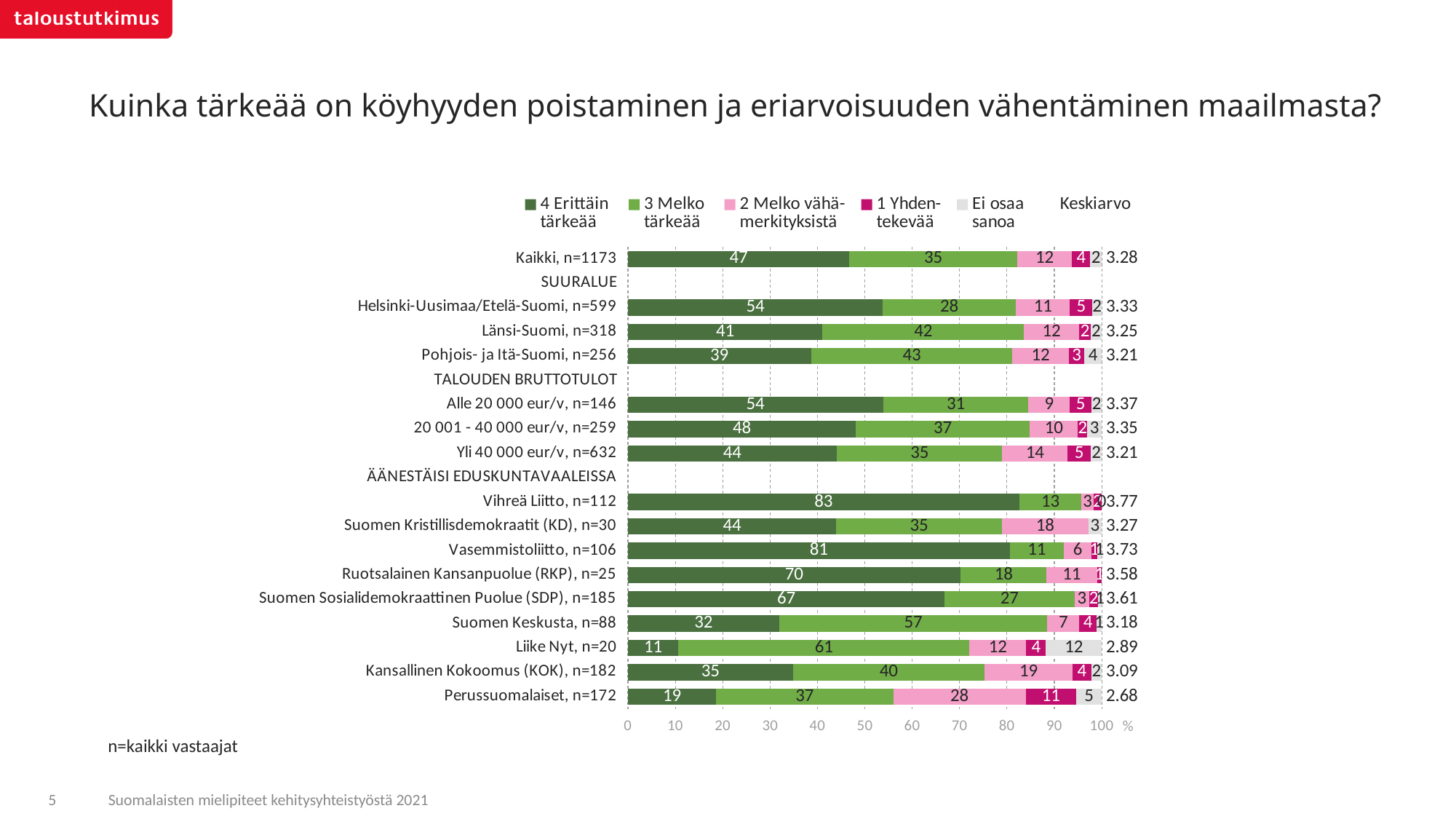
What is the Keskiarvo for Alle 20 000 eur/v, n=146? 3.37 What is the value of "4 Erittäin tärkeää" for Kaikki, n=1173? 47 What is the difference in "4 Erittäin tärkeää" between Helsinki-Uusimaa/Etelä-Suomi, n=599 and Länsi-Suomi, n=318? 13 What is the title of the chart on the slide? Kuinka tärkeää on köyhyyden poistaminen ja eriarvoisuuden vähentäminen maailmasta? What kind of chart is shown on the slide? bar chart What is the value of "1 Yhdentekevää" for Perussuomalaiset, n=172? 11 Which has a larger value for "3 Melko tärkeää": Suomen Keskusta, n=88 or Kansallinen Kokoomus (KOK), n=182? Suomen Keskusta, n=88 Which category has the lowest value for "4 Erittäin tärkeää"? Liike Nyt, n=20 Which category has the highest value for "4 Erittäin tärkeää"? Vihreä Liitto, n=112 Which category has the lowest Keskiarvo? Perussuomalaiset, n=172 What is the value of "Ei osaa sanoa" for Liike Nyt, n=20? 12 What is the Keskiarvo shown for Vihreä Liitto, n=112? 3.77